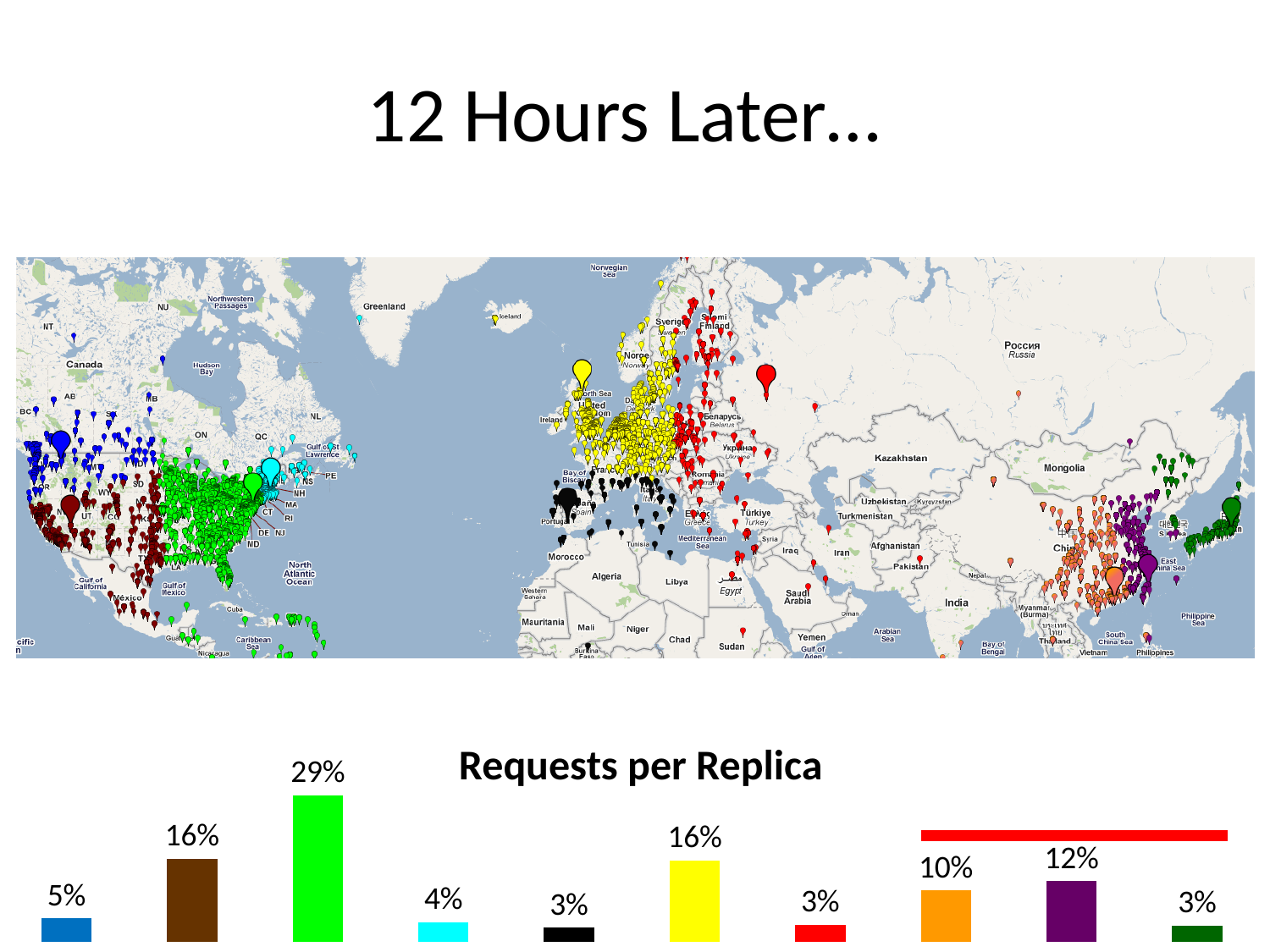
In the Requests per Replica chart, what value is labelled on the bright green bar? 29% In the Requests per Replica chart, what value is labelled on the orange bar? 10% In the Requests per Replica chart, what value is labelled on the purple bar? 12% In the Requests per Replica chart, what is the difference between the purple bar and the orange bar? 2% In the Requests per Replica chart, which is larger: the blue bar or the cyan bar? the blue bar (5%) In the Requests per Replica chart, what is the difference between the bright green bar and the brown bar? 13% In the Requests per Replica chart, what value is labelled on the yellow bar? 16% In the Requests per Replica chart, how many bars are plotted? 10 In the Requests per Replica chart, what value is labelled on the brown bar? 16% In the Requests per Replica chart, which coloured bar has the highest value? the bright green bar (29%) What is the title of the bar chart at the bottom of the slide? Requests per Replica What kind of chart is shown under the title "Requests per Replica"? bar chart